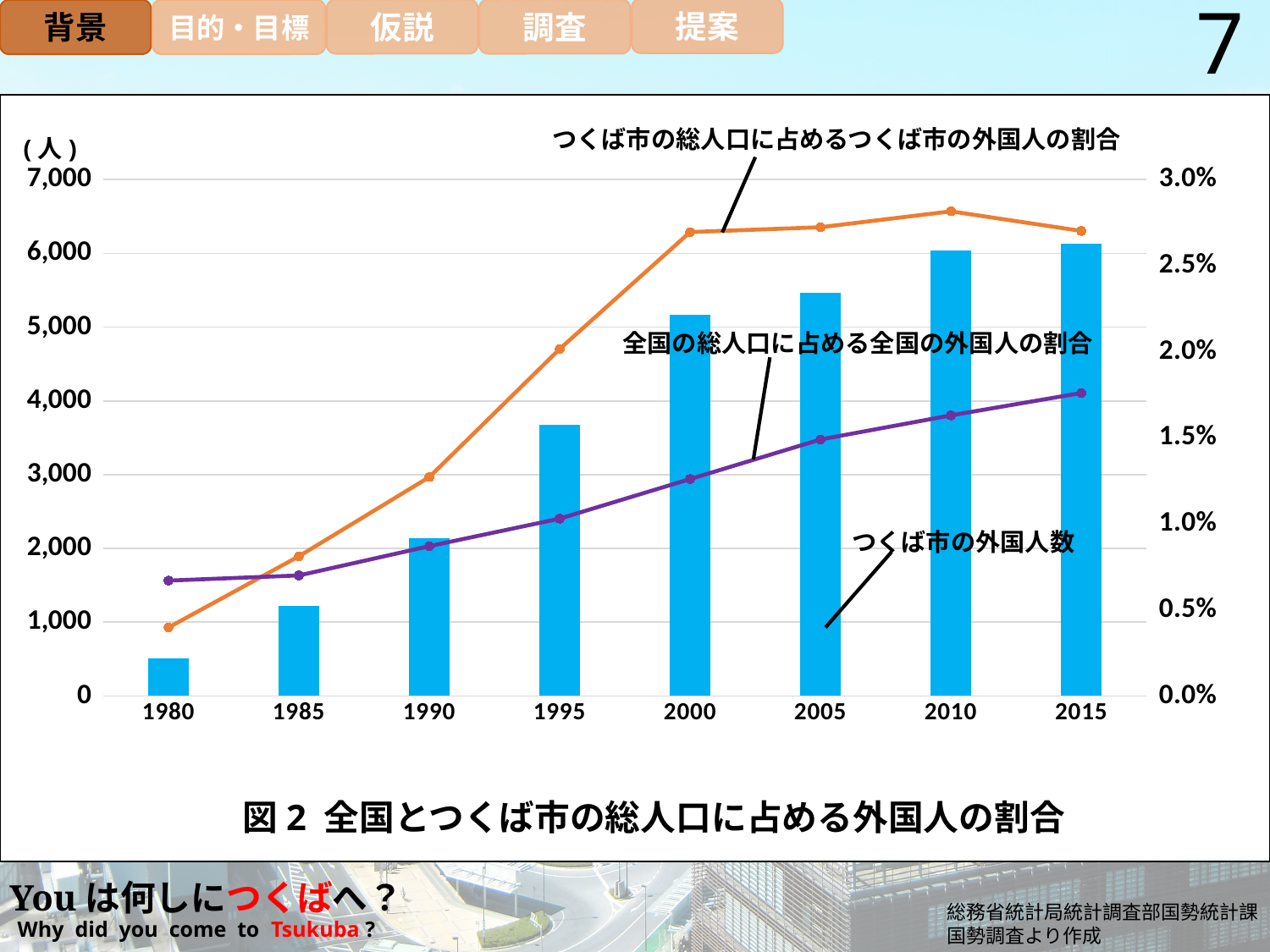
Which year has the lowest bar for つくば市の外国人数? 1980 Is the bar for つくば市の外国人数 in 2000 greater or less than 5,000? greater Is the value of 全国の総人口に占める全国の外国人の割合 in 2015 greater or less than 1.5%? greater How many data series are labelled on the chart? 3 In which year does the line for つくば市の総人口に占めるつくば市の外国人の割合 reach its highest point? 2010 Is the bar for つくば市の外国人数 in 1995 greater or less than 4,000? less In which year does the line for 全国の総人口に占める全国の外国人の割合 reach its highest point? 2015 Do the bars for つくば市の外国人数 generally rise or fall from 1980 to 2015? Rise How many years are shown along the x axis of the chart? 8 In 1980, which is higher: the Tsukuba foreigner ratio line or the national foreigner ratio line? The national foreigner ratio line (全国の総人口に占める全国の外国人の割合) What kind of chart is shown on the slide? A combined bar and line chart